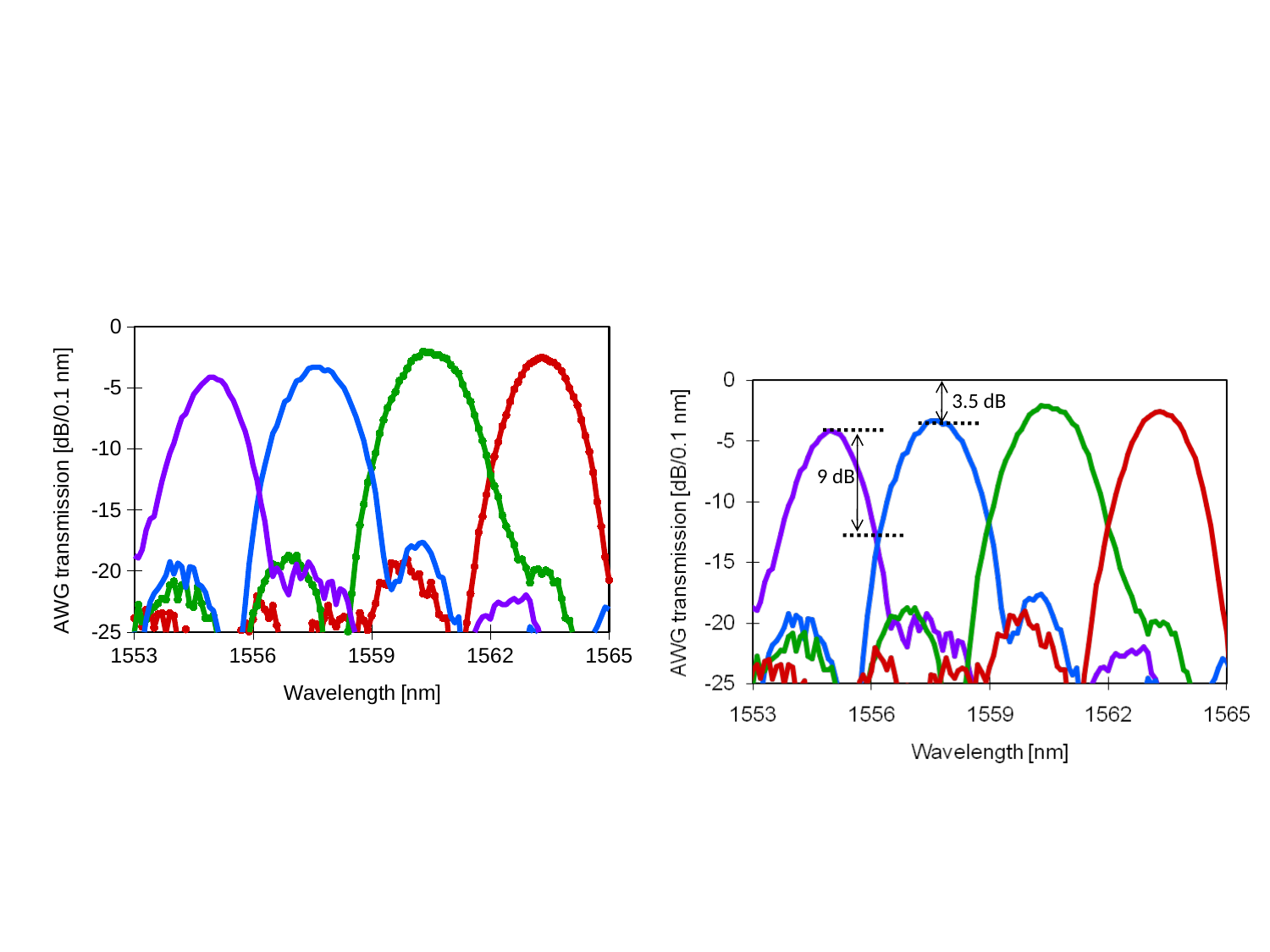
On the left chart, what is the lowest value shown on the y-axis? -25 What kind of chart is the left chart? line chart On the right chart, what value is written next to the vertical arrow between the purple peak and the crossing point with the blue curve? 9 dB On the left chart, is the peak of the purple curve greater or less than -5? greater On the left chart, which curve has the higher peak, the green curve or the purple curve? green On the left chart, is the peak of the green curve greater or less than -5? greater On the right chart, is the peak of the red curve greater or less than -10? greater On the right chart, what value is written next to the upper annotation arrow at the blue curve's peak? 3.5 dB What is the x-axis label of the left chart? Wavelength [nm] What is the y-axis label of the right chart? AWG transmission [dB/0.1 nm] On the left chart, how many coloured transmission curves are plotted? 4 On the right chart, which curve peaks at the longest wavelength? red